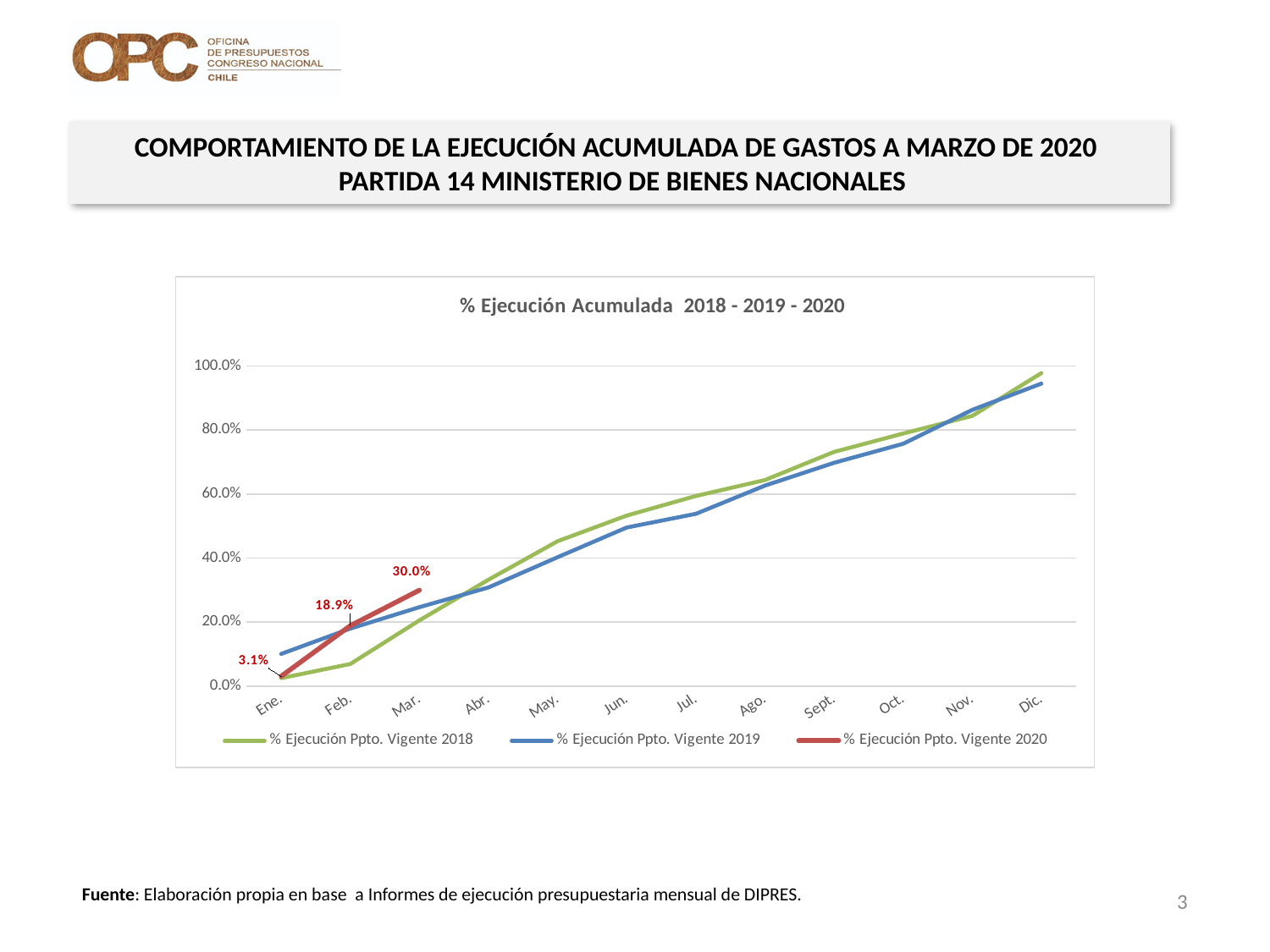
Is the value for % Ejecución Ppto. Vigente 2018 in Dic. greater or less than 80.0%? greater Is the value for % Ejecución Ppto. Vigente 2019 in Ene. greater or less than 20.0%? less What is the value for % Ejecución Ppto. Vigente 2020 in Mar.? 30.0% How many months are shown on the x axis? 12 What is the value for % Ejecución Ppto. Vigente 2020 in Feb.? 18.9% In Feb., which series has the higher value: % Ejecución Ppto. Vigente 2018 or % Ejecución Ppto. Vigente 2019? % Ejecución Ppto. Vigente 2019 What is the value for % Ejecución Ppto. Vigente 2020 in Ene.? 3.1% What is the title of the chart? % Ejecución Acumulada 2018 - 2019 - 2020 What is the difference between the 2020 values for Mar. and Feb.? 11.1% What is the difference between the 2020 values for Feb. and Ene.? 15.8% How many series does the legend list? 3 What type of chart is shown on the slide? line chart